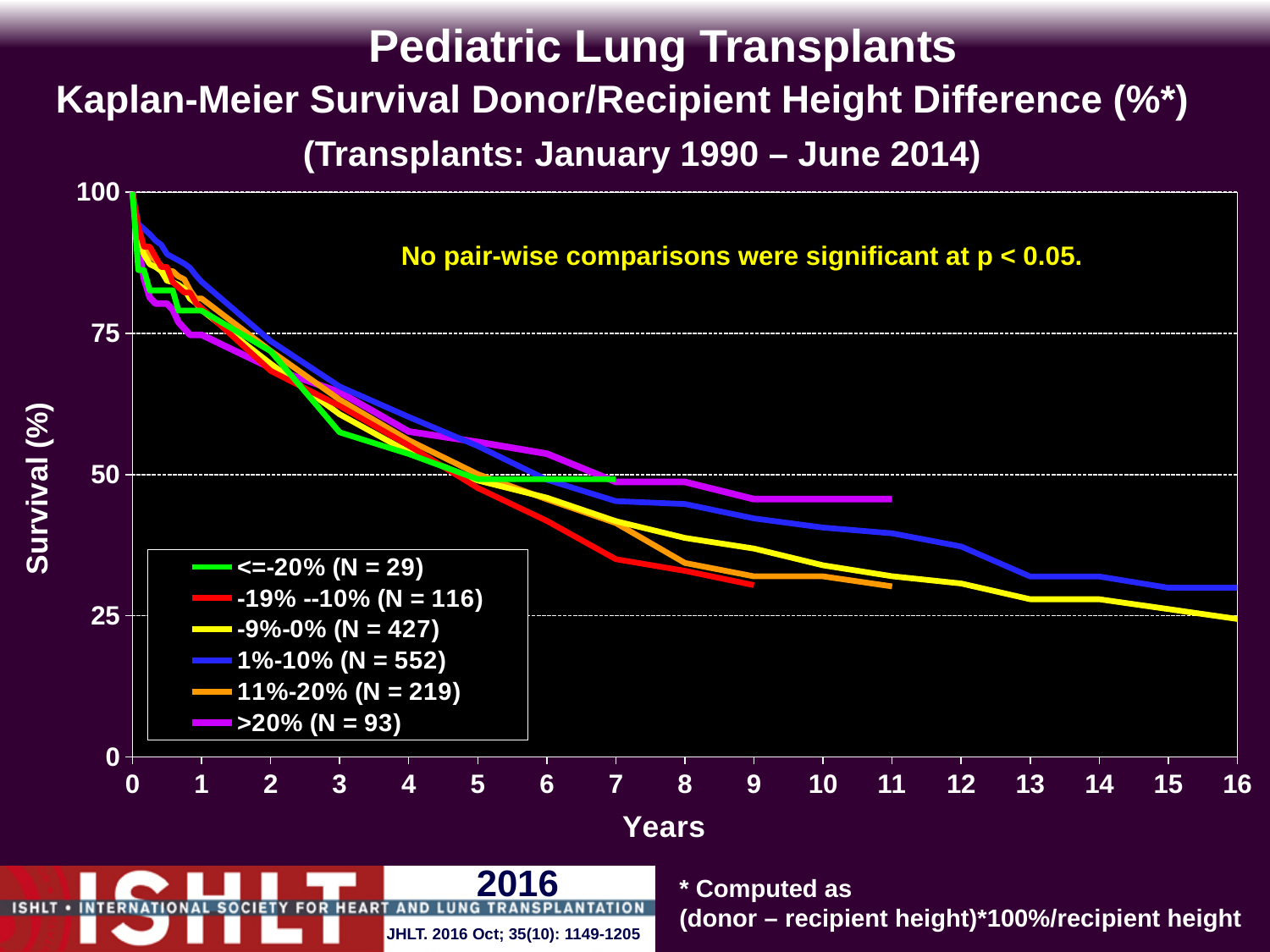
At 16 years, which series has the higher survival: 1%-10% or -9%-0%? 1%-10% At 9 years, which series has the higher survival: -19% --10% or 1%-10%? 1%-10% Is the survival value for the 1%-10% series at 16 years greater or less than 25? greater Is the survival value for the >20% series at 11 years greater or less than 50? less Is the survival value for the 1%-10% series at 1 year greater or less than 75? greater What is the N for the <=-20% group shown in the legend? 29 How many series does the legend list? 6 What kind of chart is shown on the slide? line chart Do the survival curves rise or fall as years increase? fall What is the N for the 1%-10% group shown in the legend? 552